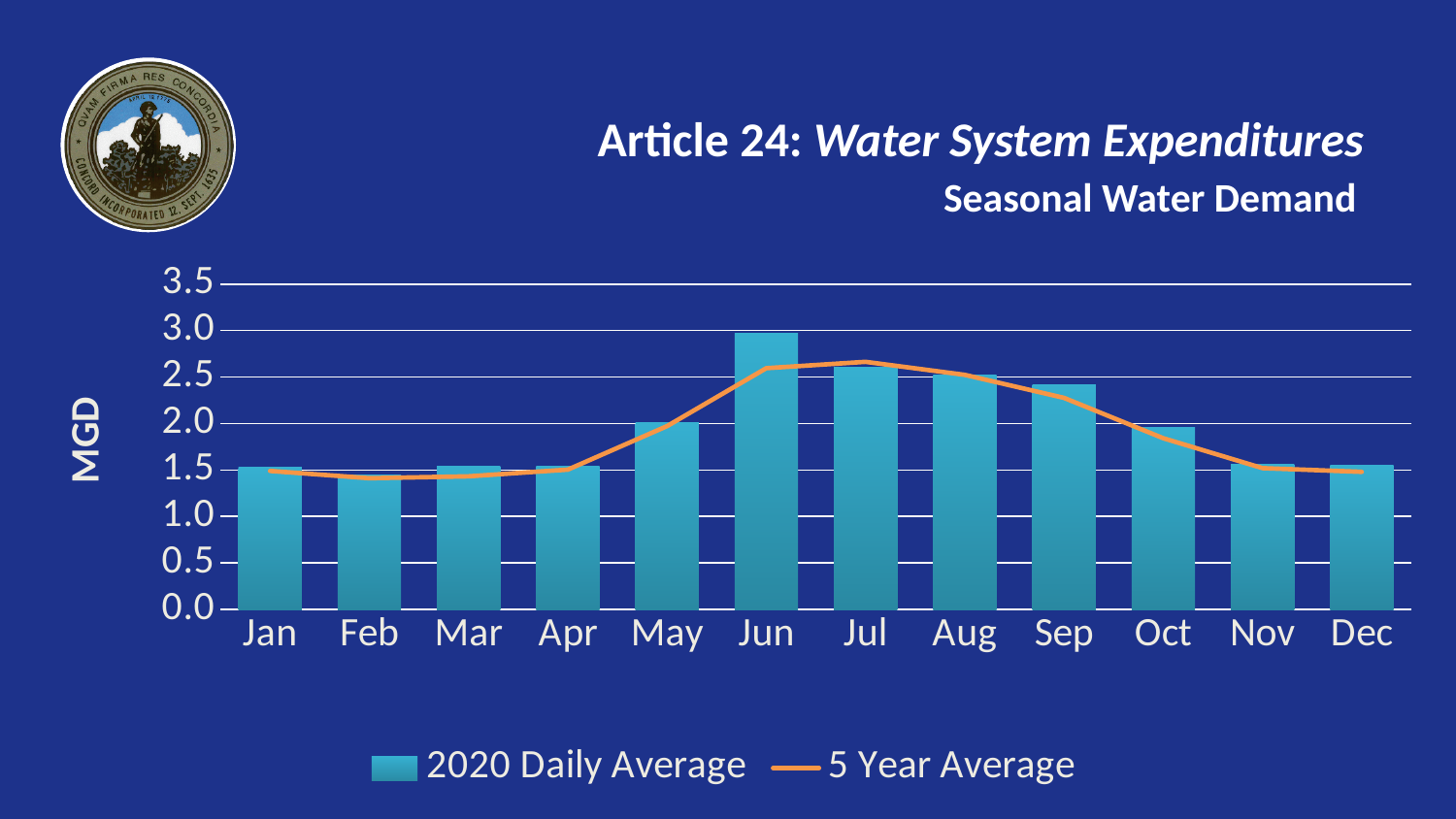
How many months are shown on the x axis? 12 How many series does the legend list? 2 Is the 2020 Daily Average value for Jan greater or less than 2.0? less What kind of chart is shown on the slide? A bar chart with a line series What is the label on the y axis? MGD Which is larger, the 2020 Daily Average bar for Aug or for Dec? Aug Which month has the highest 2020 Daily Average bar? Jun Do the 2020 Daily Average bars rise or fall from Jun to Dec? fall Is the 5 Year Average value for Jun greater or less than 2.0? greater Is the 2020 Daily Average value for May greater or less than 2.5? less Which is larger, the 2020 Daily Average bar for Jun or for Jul? Jun